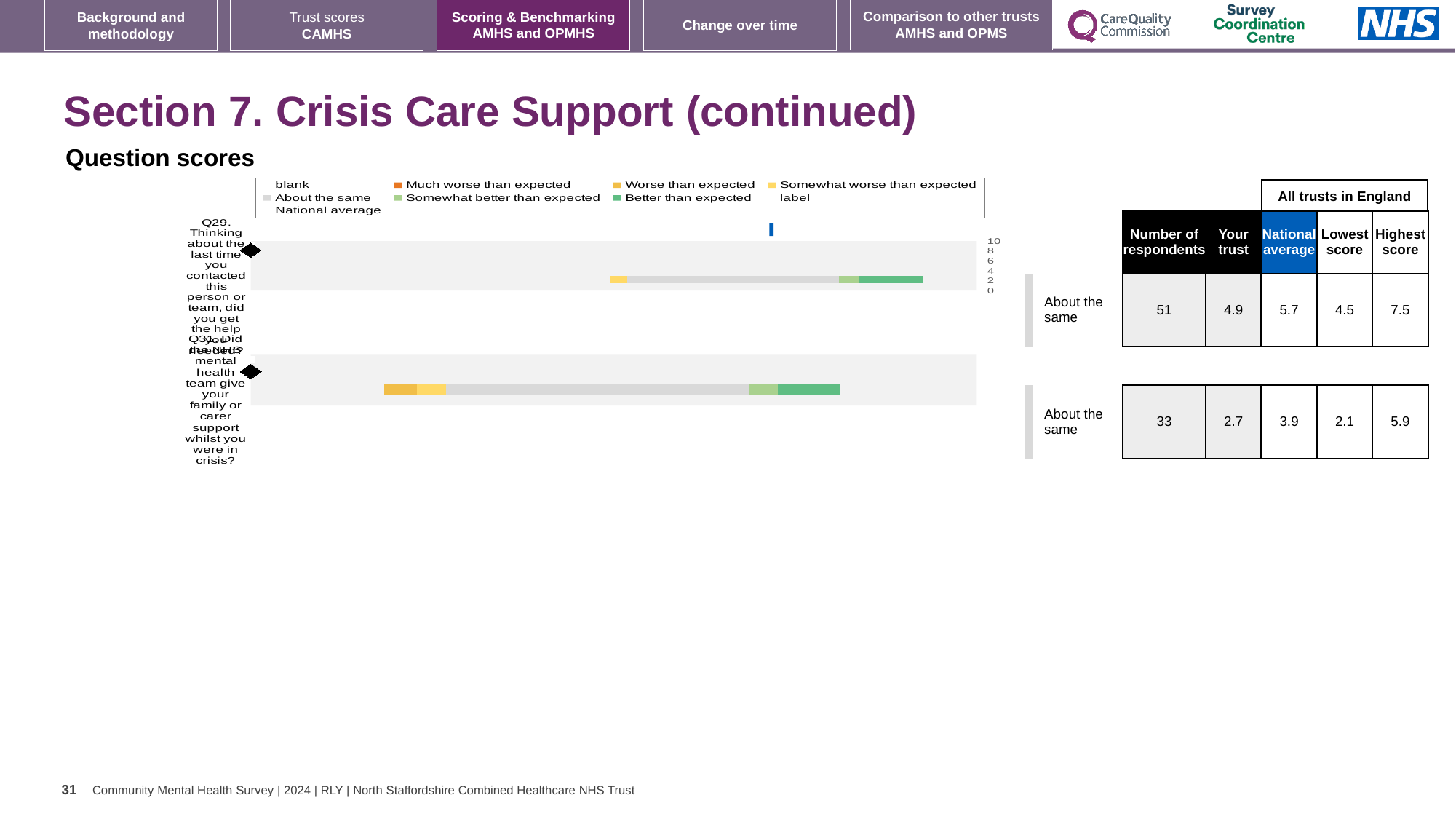
For Q29, which is larger: the 'Your trust' score or the national average? National average How many respondents answered Q31? 33 What is the difference between the national average and the 'Your trust' score for Q29? 0.8 What is the 'Your trust' score for Q29? 4.9 How many questions (bars) are plotted in the chart? 2 What kind of chart is shown under 'Question scores'? bar chart What is the highest score among all trusts in England for Q29? 7.5 How many entries does the chart legend list? 9 What is the national average score for Q31? 3.9 What is the difference between the highest and lowest scores for Q31? 3.8 What colour represents 'Much worse than expected' in the legend? orange What colour represents 'Better than expected' in the legend? green